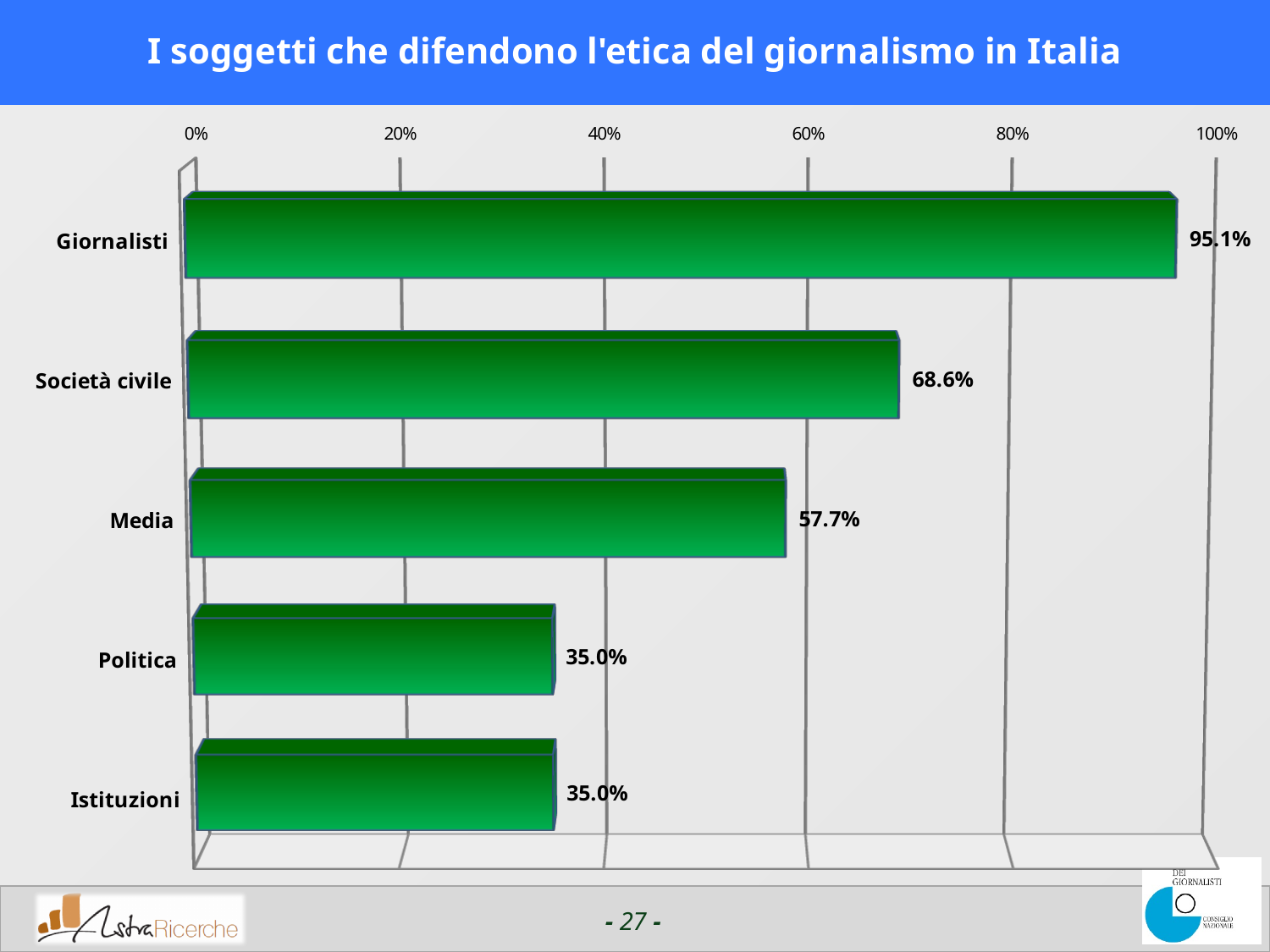
What is the value for Politica? 35.0% What kind of chart is shown on the slide? bar chart Is the value for Media greater or less than 60%? less What is the value for Giornalisti? 95.1% What is the difference between the values for Giornalisti and Società civile? 26.5% What is the title of the chart? I soggetti che difendono l'etica del giornalismo in Italia How many categories are shown in the chart? 5 What is the value for Società civile? 68.6% Which category has the highest value? Giornalisti Which is larger, the value for Media or the value for Politica? Media What is the value for Media? 57.7% What is the difference between the values for Società civile and Media? 10.9%